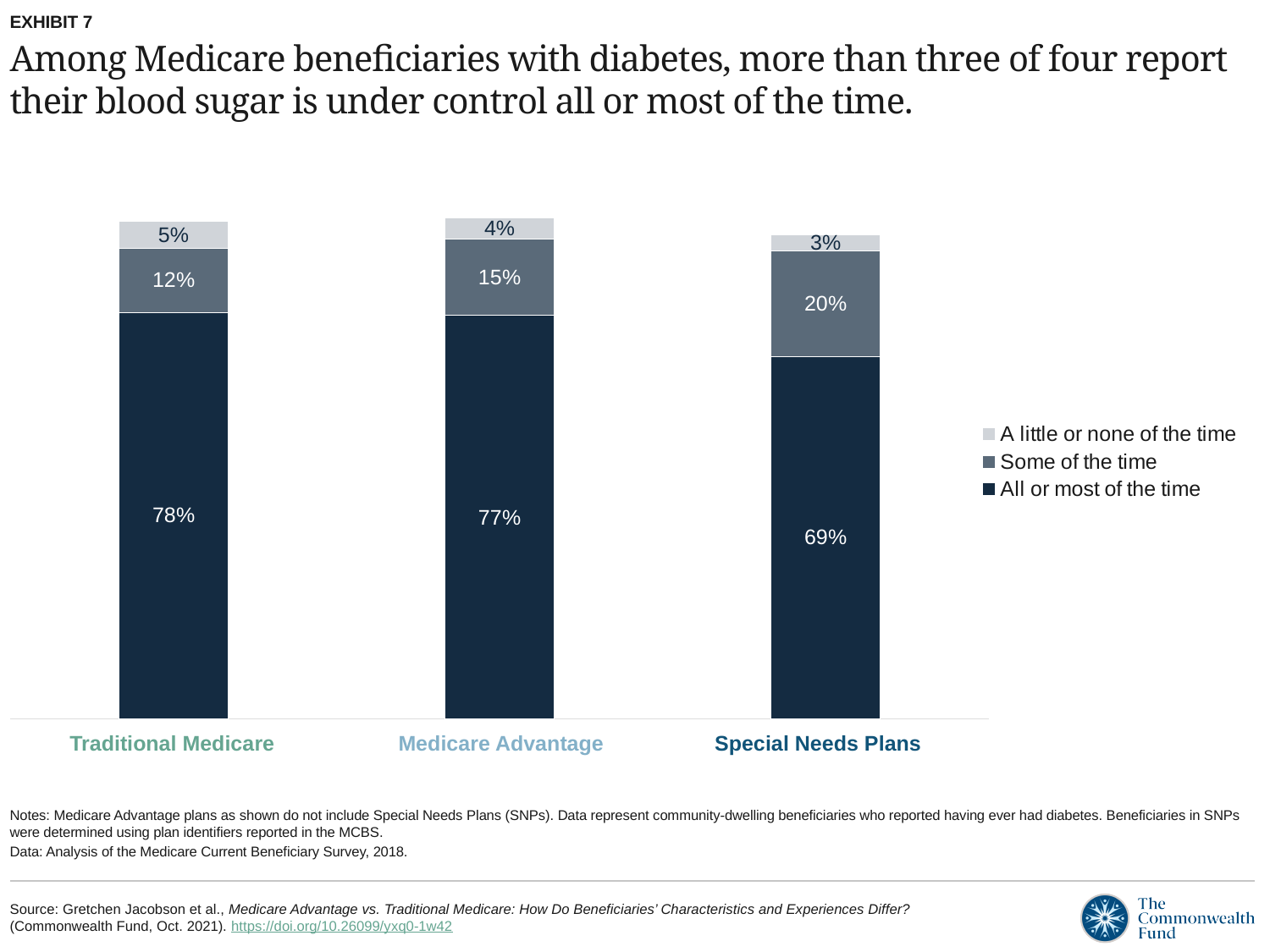
Which legend entry is shown in the darkest colour? All or most of the time Which plan type has the lowest share reporting blood sugar under control all or most of the time? Special Needs Plans What is the value for 'A little or none of the time' for Medicare Advantage? 4% How many plan types are shown on the x axis? 3 Which plan type has the highest share reporting 'Some of the time'? Special Needs Plans What is the value for 'Some of the time' for Special Needs Plans? 20% What kind of chart is shown on the slide? Stacked bar chart What is the total of the three segments in the Medicare Advantage bar? 96% What percentage of Traditional Medicare beneficiaries report their blood sugar is under control all or most of the time? 78% What is the difference between the 'All or most of the time' values for Traditional Medicare and Special Needs Plans? 9 percentage points Which is larger: the 'Some of the time' value for Medicare Advantage or for Traditional Medicare? Medicare Advantage How many series does the legend list? 3